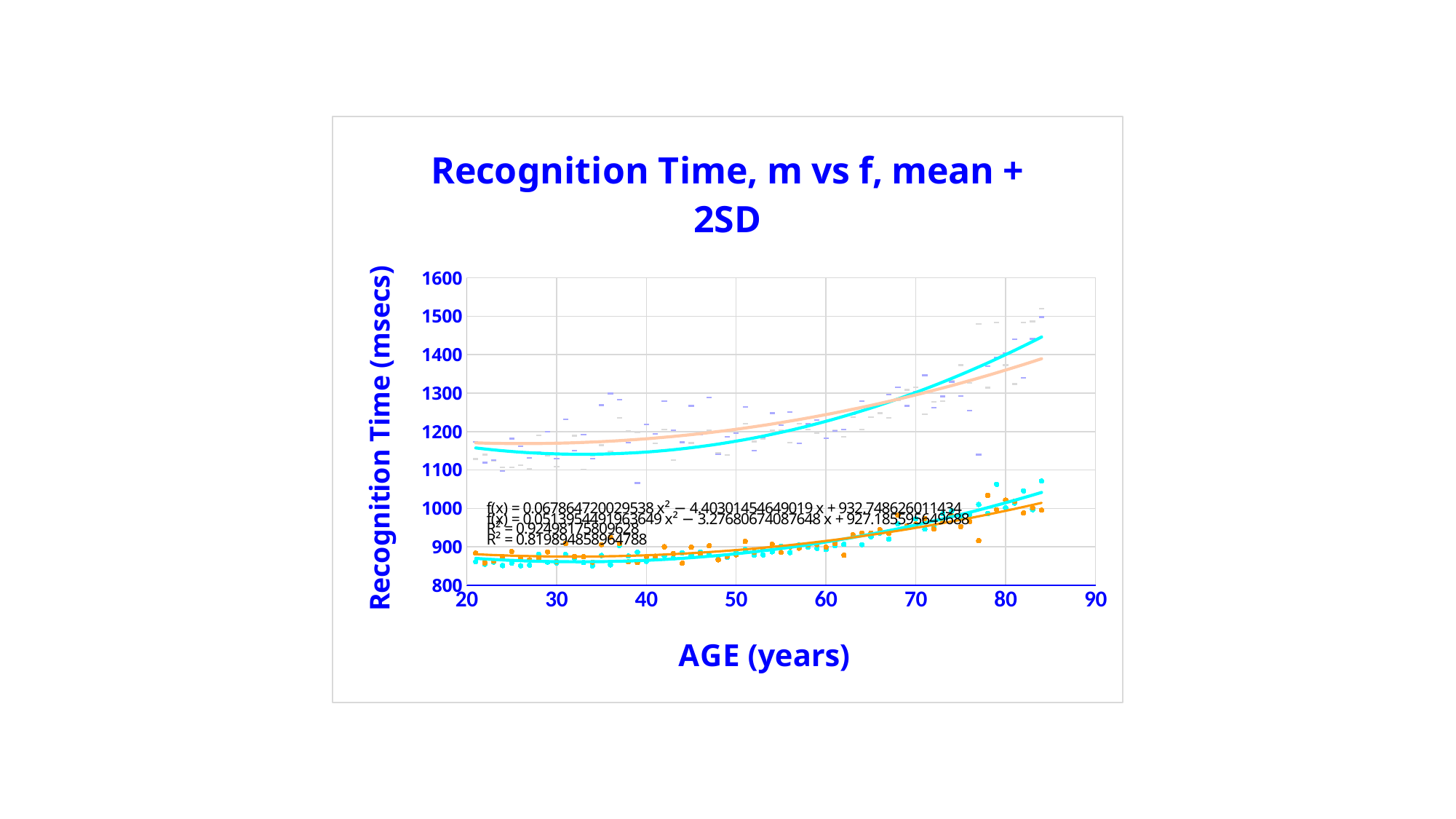
Is the upper cyan trendline at age 84 greater or less than 1400 msecs? greater What is the title of the vertical axis? Recognition Time (msecs) Are the lower cluster of points (cyan and orange) at age 80 greater or less than 900 msecs? greater Do the recognition time values rise or fall as age increases from 50 to 80 years? rise Are the lower cluster of points (cyan and orange) at age 30 greater or less than 900 msecs? less What kind of chart is shown on the slide? scatter chart What is the title of the chart? Recognition Time, m vs f, mean + 2SD